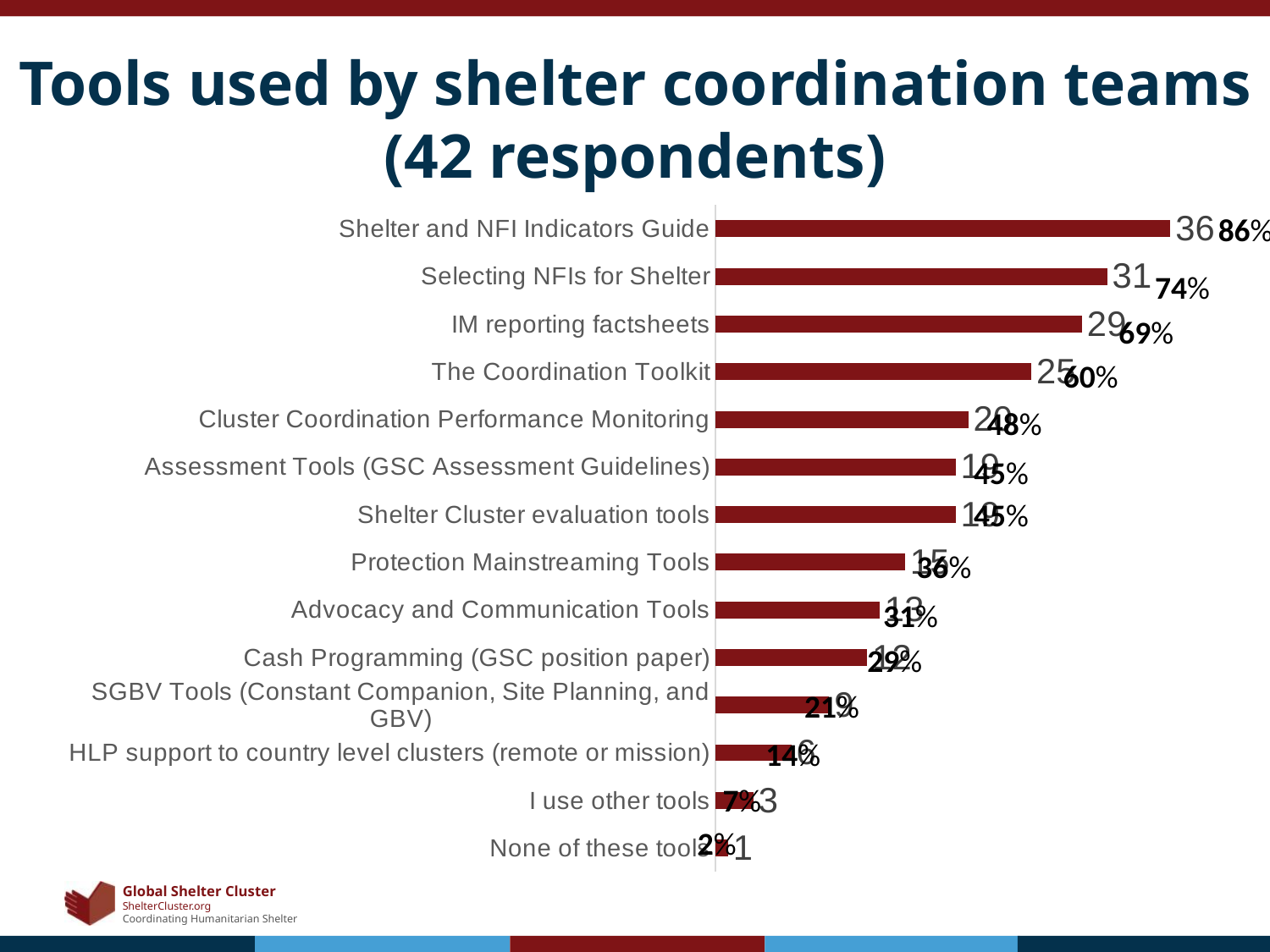
What type of chart is shown on the slide? Bar chart How many respondents does the chart title say took part in the survey? 42 What percentage of respondents use Selecting NFIs for Shelter? 74% Which tool is used by the highest share of respondents? Shelter and NFI Indicators Guide How many more respondents use the Shelter and NFI Indicators Guide than Selecting NFIs for Shelter? 5 What percentage of respondents selected 'None of these tools'? 2% Which is used by more respondents: The Coordination Toolkit or Protection Mainstreaming Tools? The Coordination Toolkit What percentage of respondents use IM reporting factsheets? 69% How many tool categories are shown in the chart? 14 Which category has the lowest value in the chart? None of these tools How many respondents use the Shelter and NFI Indicators Guide? 36 What percentage of respondents use the Shelter and NFI Indicators Guide? 86%